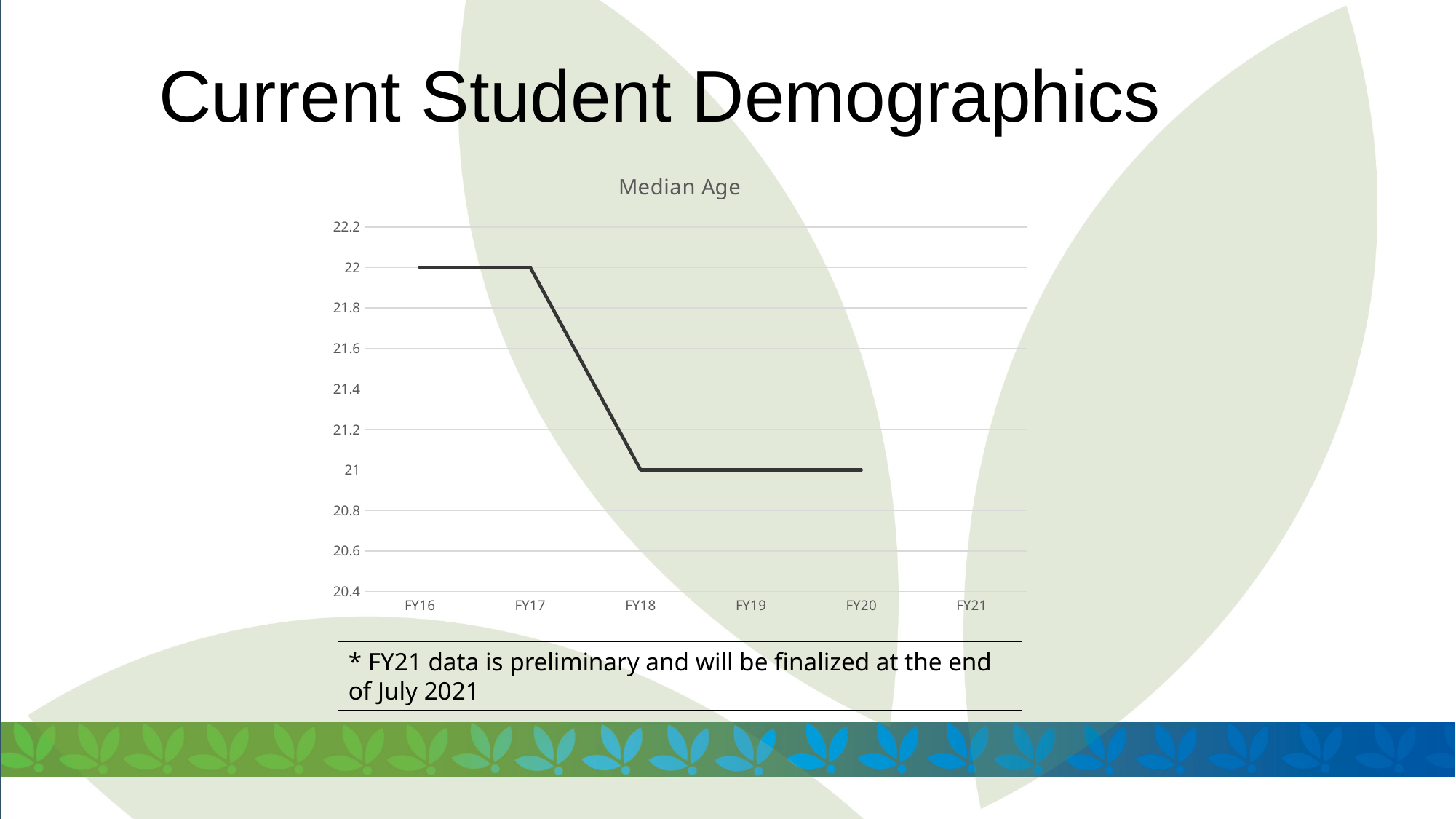
What is the median age for FY16? 22 Which fiscal year on the x axis has no data point plotted? FY21 Which of FY17 or FY19 has the higher median age? FY17 How many fiscal years are labelled on the x axis? 6 What is the title of the chart? Median Age What is the median age for FY18? 21 What is the median age for FY20? 21 What is the difference in median age between FY16 and FY18? 1 Does the median age rise or fall from FY16 to FY20? fall What kind of chart is shown on the slide? line chart What is the median age for FY17? 22 Is the median age for FY19 greater or less than 21.4? less